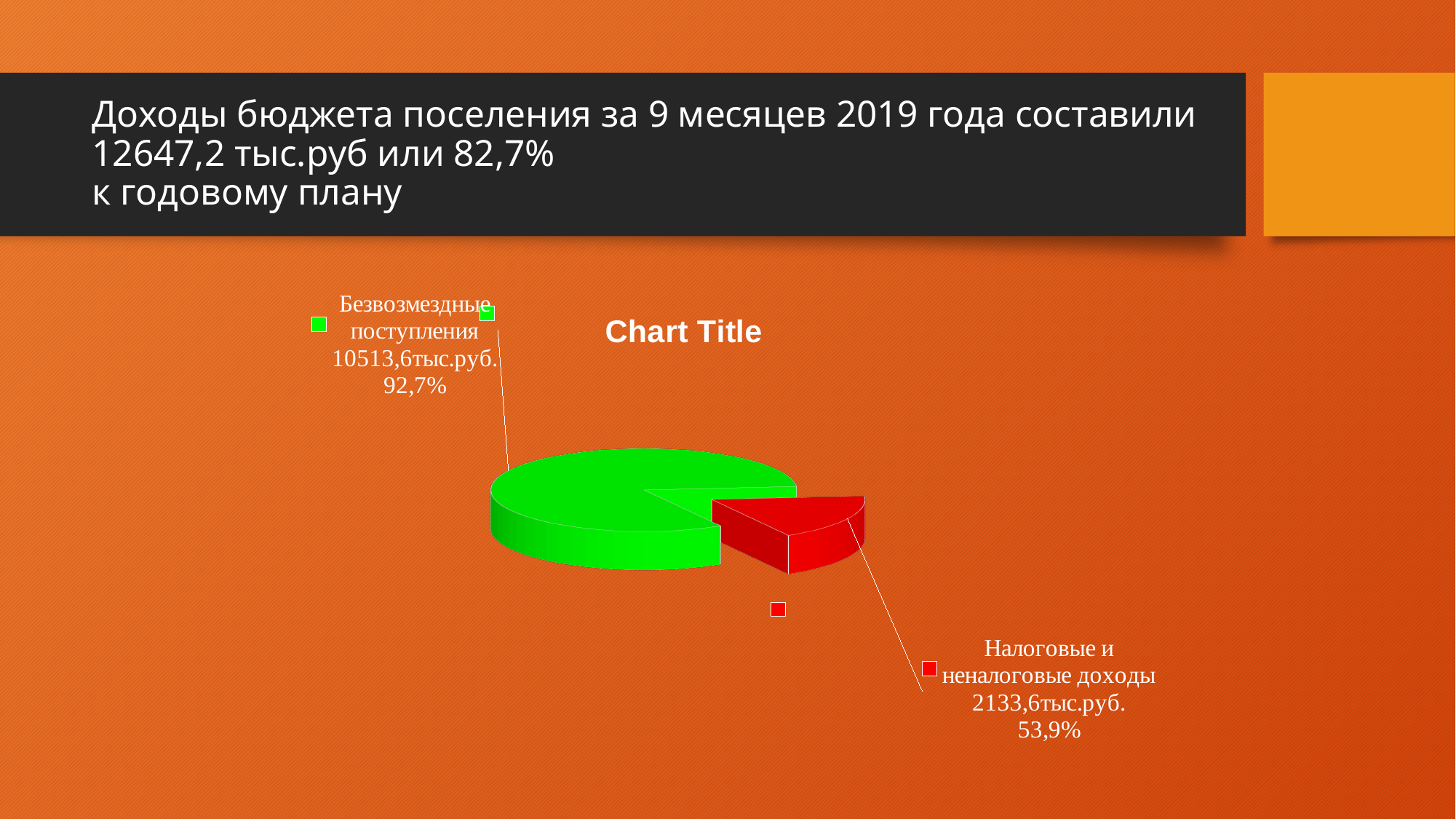
What percentage is printed next to Налоговые и неналоговые доходы? 53,9% Which slice of the pie chart is the smallest? Налоговые и неналоговые доходы Which is larger: Безвозмездные поступления or Налоговые и неналоговые доходы? Безвозмездные поступления What colour is the slice for Налоговые и неналоговые доходы? red What kind of chart is shown on the slide? pie chart What is the title shown above the pie chart? Chart Title What amount is shown for Безвозмездные поступления? 10513,6тыс.руб. Which slice of the pie chart is the largest? Безвозмездные поступления What amount is shown for Налоговые и неналоговые доходы? 2133,6тыс.руб. How many slices does the pie chart have? 2 What is the difference between Безвозмездные поступления (10513,6тыс.руб.) and Налоговые и неналоговые доходы (2133,6тыс.руб.)? 8380,0 тыс.руб. What percentage is printed next to Безвозмездные поступления? 92,7%